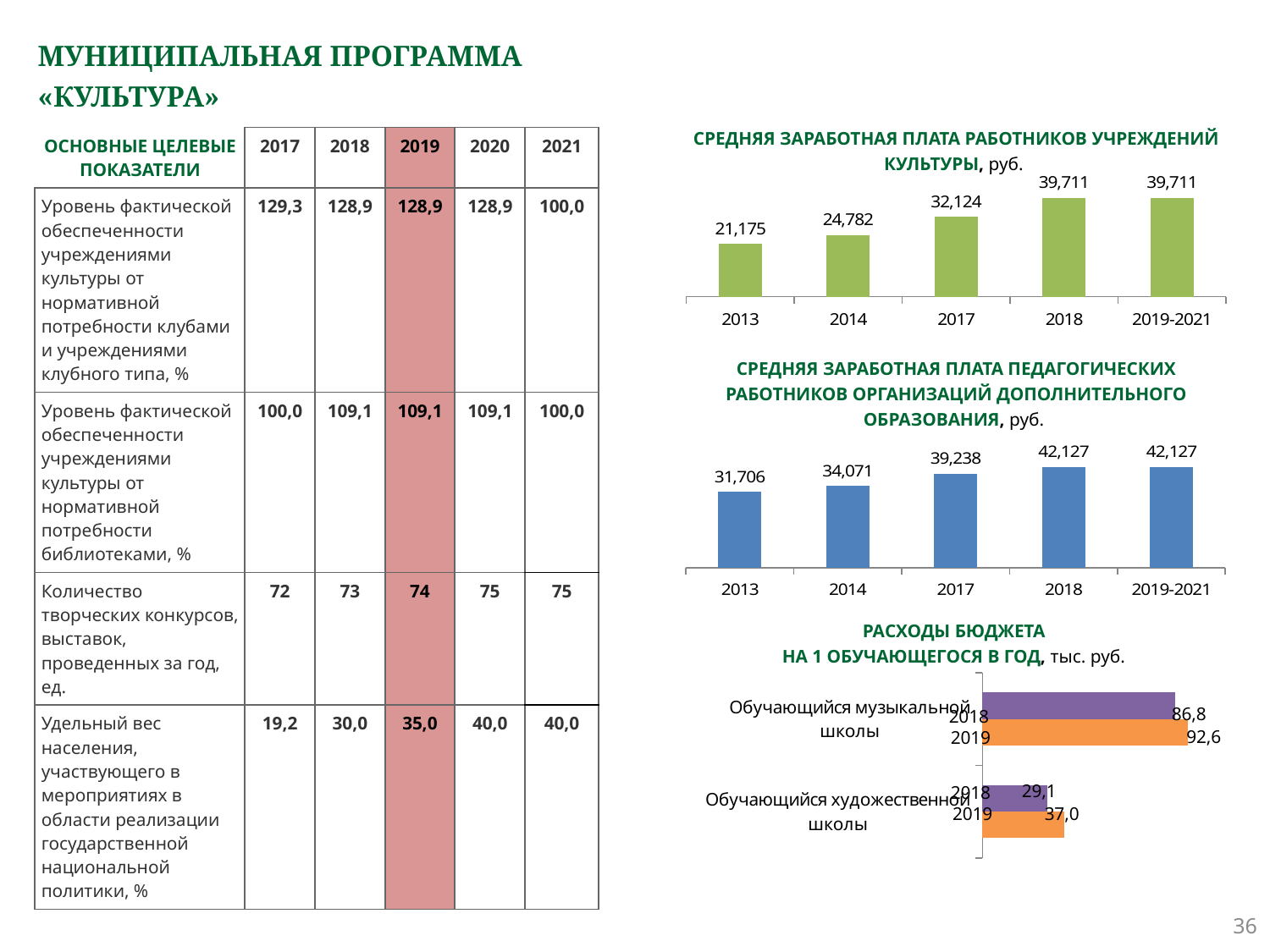
На диаграмме «Средняя заработная плата работников учреждений культуры» какое значение указано для 2017 года? 32,124 На диаграмме «Расходы бюджета на 1 обучающегося в год» какое значение указано для обучающегося музыкальной школы в 2019 году? 92,6 На диаграмме «Средняя заработная плата работников учреждений культуры» сколько категорий показано по оси x? 5 На диаграмме «Средняя заработная плата работников учреждений культуры» какая категория имеет наименьшее значение? 2013 На диаграмме «Средняя заработная плата педагогических работников организаций дополнительного образования» на сколько значение 2017 года больше значения 2013 года? 7,532 На диаграмме «Средняя заработная плата педагогических работников организаций дополнительного образования» какое значение указано для 2014 года? 34,071 Какого типа диаграмма «Расходы бюджета на 1 обучающегося в год»? столбчатая (bar chart) На диаграмме «Средняя заработная плата работников учреждений культуры» какое значение указано для 2013 года? 21,175 На диаграмме «Средняя заработная плата педагогических работников организаций дополнительного образования» какое значение указано для 2018 года? 42,127 На диаграмме «Средняя заработная плата педагогических работников организаций дополнительного образования» значения растут или падают от 2013 к 2018 году? растут На диаграмме «Средняя заработная плата работников учреждений культуры» на сколько значение 2018 года больше значения 2014 года? 14,929 На диаграмме «Расходы бюджета на 1 обучающегося в год» что больше: расходы на обучающегося художественной школы в 2018 году или в 2019 году? в 2019 году